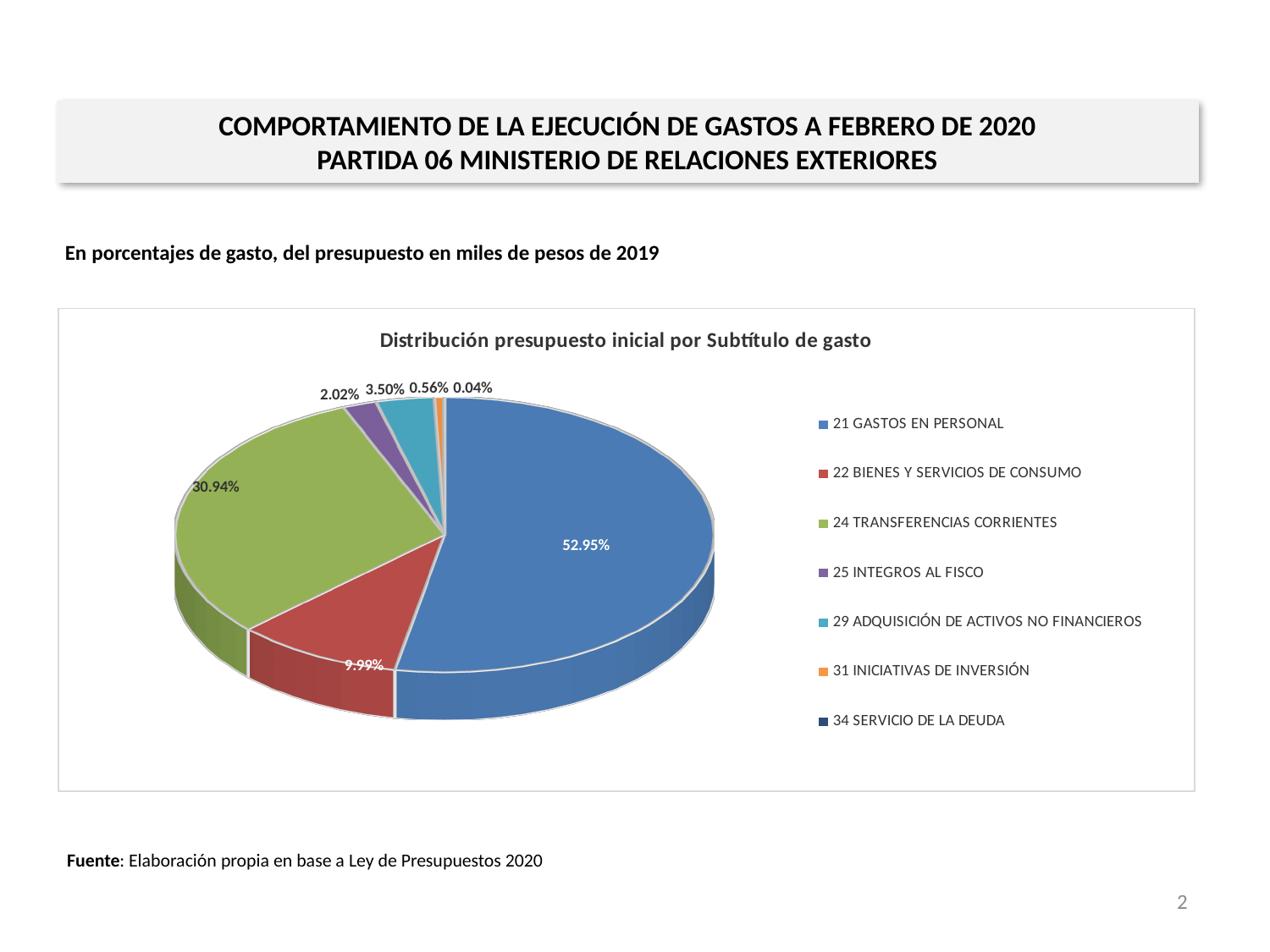
What is the difference in percentage points between 21 GASTOS EN PERSONAL and 24 TRANSFERENCIAS CORRIENTES? 22.01 Which is larger, the share for 25 INTEGROS AL FISCO or the share for 29 ADQUISICIÓN DE ACTIVOS NO FINANCIEROS? 29 ADQUISICIÓN DE ACTIVOS NO FINANCIEROS How many categories does the legend list? 7 What percentage is shown for 24 TRANSFERENCIAS CORRIENTES? 30.94% Which category has the smallest share of the pie? 34 SERVICIO DE LA DEUDA What kind of chart is shown on the slide? pie chart What percentage is shown for 34 SERVICIO DE LA DEUDA? 0.04% What percentage is shown for 22 BIENES Y SERVICIOS DE CONSUMO? 9.99% What is the title of the chart? Distribución presupuesto inicial por Subtítulo de gasto What percentage is shown for 21 GASTOS EN PERSONAL? 52.95% Which category has the largest share of the pie? 21 GASTOS EN PERSONAL What percentage is shown for 29 ADQUISICIÓN DE ACTIVOS NO FINANCIEROS? 3.50%